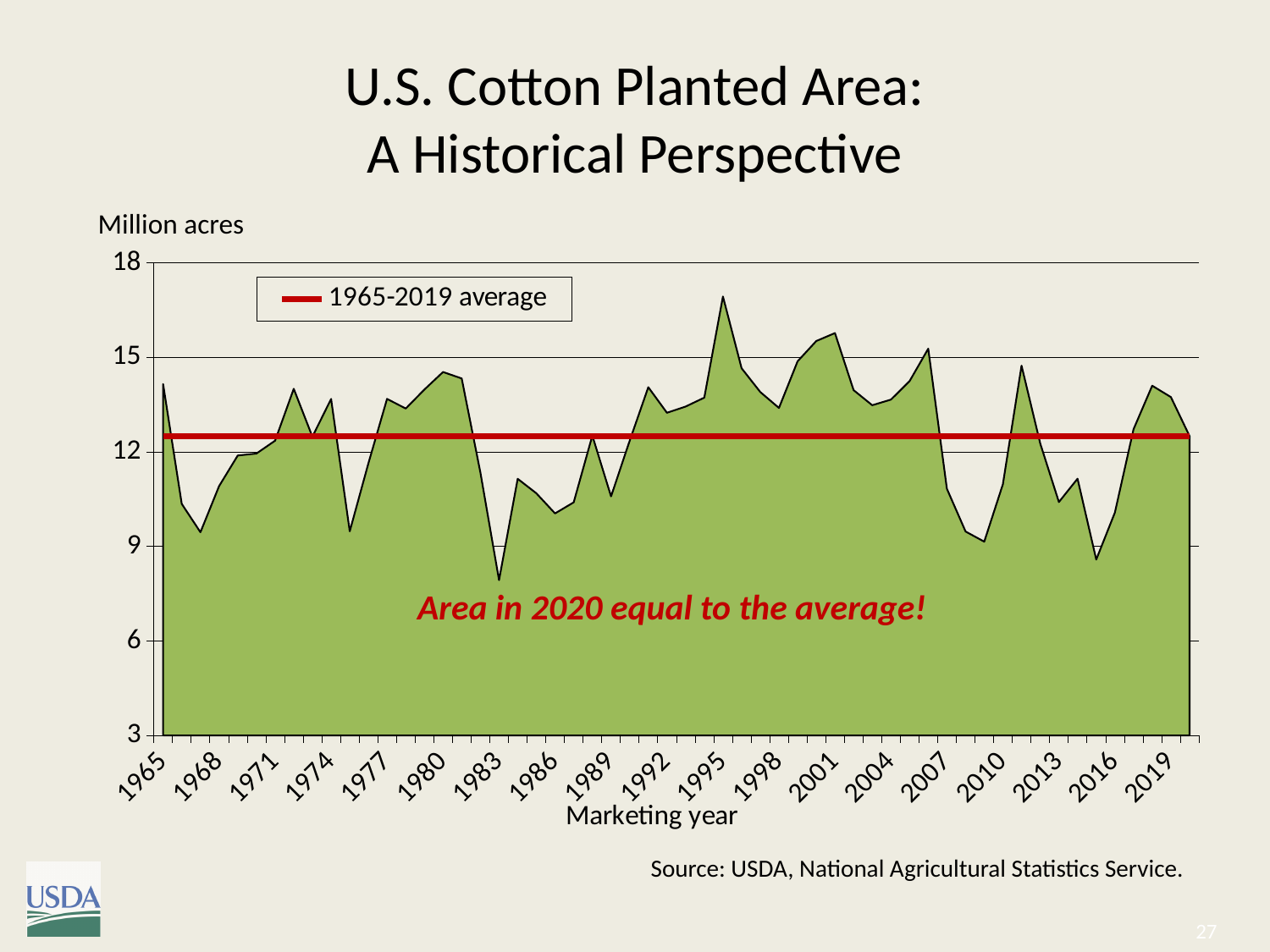
What kind of chart is shown on the slide? Area chart Which year had a larger planted area, 1995 or 2001? 1995 How many entries does the legend list? 1 Is the planted area for 1995 greater or less than 15 million acres? greater Is the planted area for 2009 greater or less than 12 million acres? less In which marketing year was U.S. cotton planted area lowest? 1983 In which marketing year was U.S. cotton planted area highest? 1995 Is the planted area for 1983 greater or less than 9 million acres? less What entry does the chart's legend list? 1965-2019 average Did the planted area rise or fall from 2007 to 2009? fall What is the title of the chart? U.S. Cotton Planted Area: A Historical Perspective